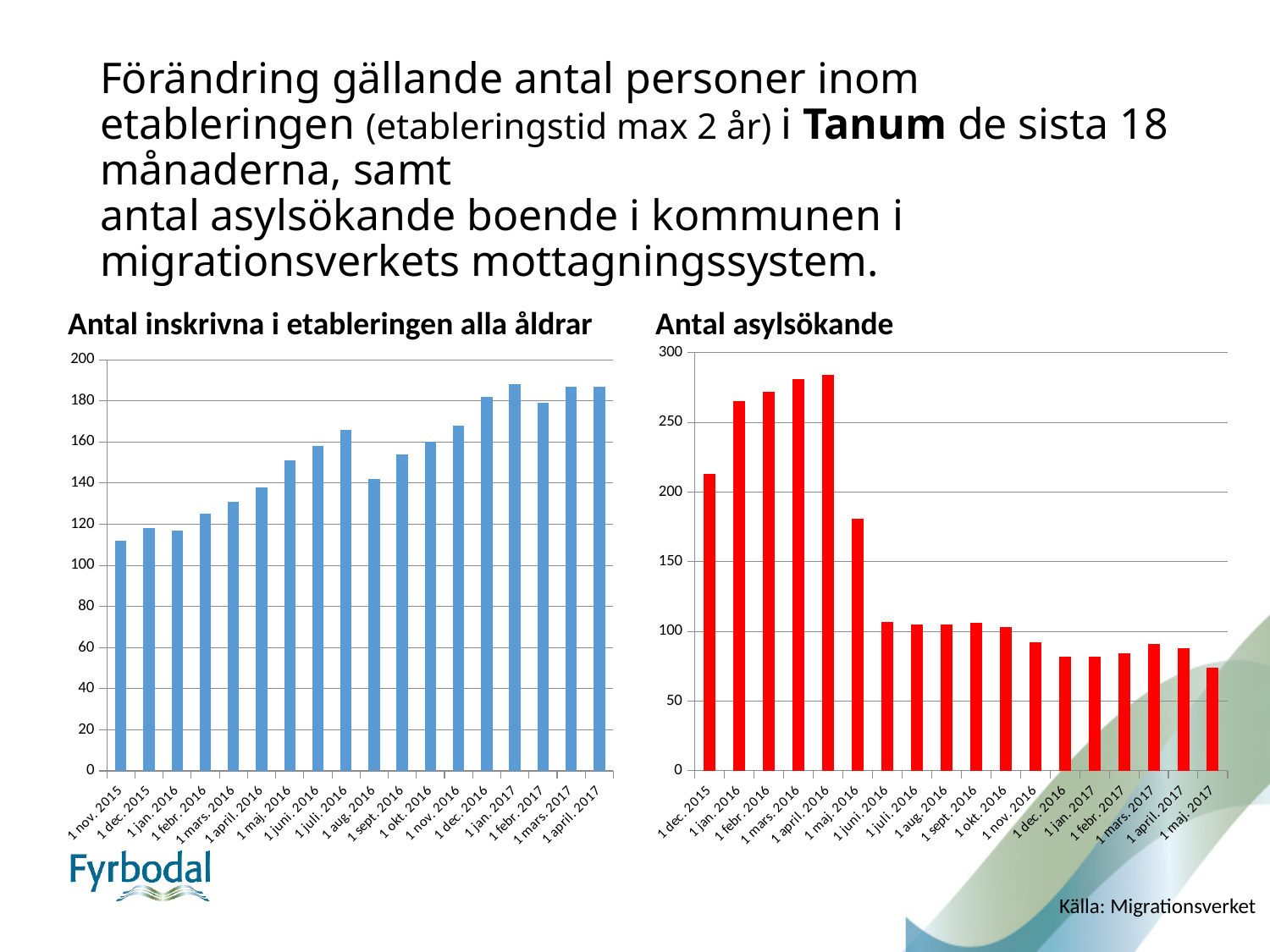
How many bars are shown in the "Antal inskrivna i etableringen alla åldrar" chart? 18 In the "Antal asylsökande" chart, which is larger: the value for 1 febr. 2016 or the value for 1 nov. 2016? 1 febr. 2016 In the "Antal inskrivna i etableringen alla åldrar" chart, which is larger: the value for 1 dec. 2016 or the value for 1 april 2016? 1 dec. 2016 In the "Antal inskrivna i etableringen alla åldrar" chart, is the value for 1 nov. 2015 greater or less than 120? less In the "Antal inskrivna i etableringen alla åldrar" chart, is the value for 1 jan. 2017 greater or less than 180? greater How many bars are shown in the "Antal asylsökande" chart? 18 In the "Antal asylsökande" chart, is the value for 1 dec. 2015 greater or less than 200? greater In the "Antal asylsökande" chart, which date has the lowest value? 1 maj 2017 In the "Antal asylsökande" chart, do the values generally rise or fall from 1 dec. 2015 to 1 maj 2017? fall What kind of chart is the "Antal asylsökande" chart? bar chart